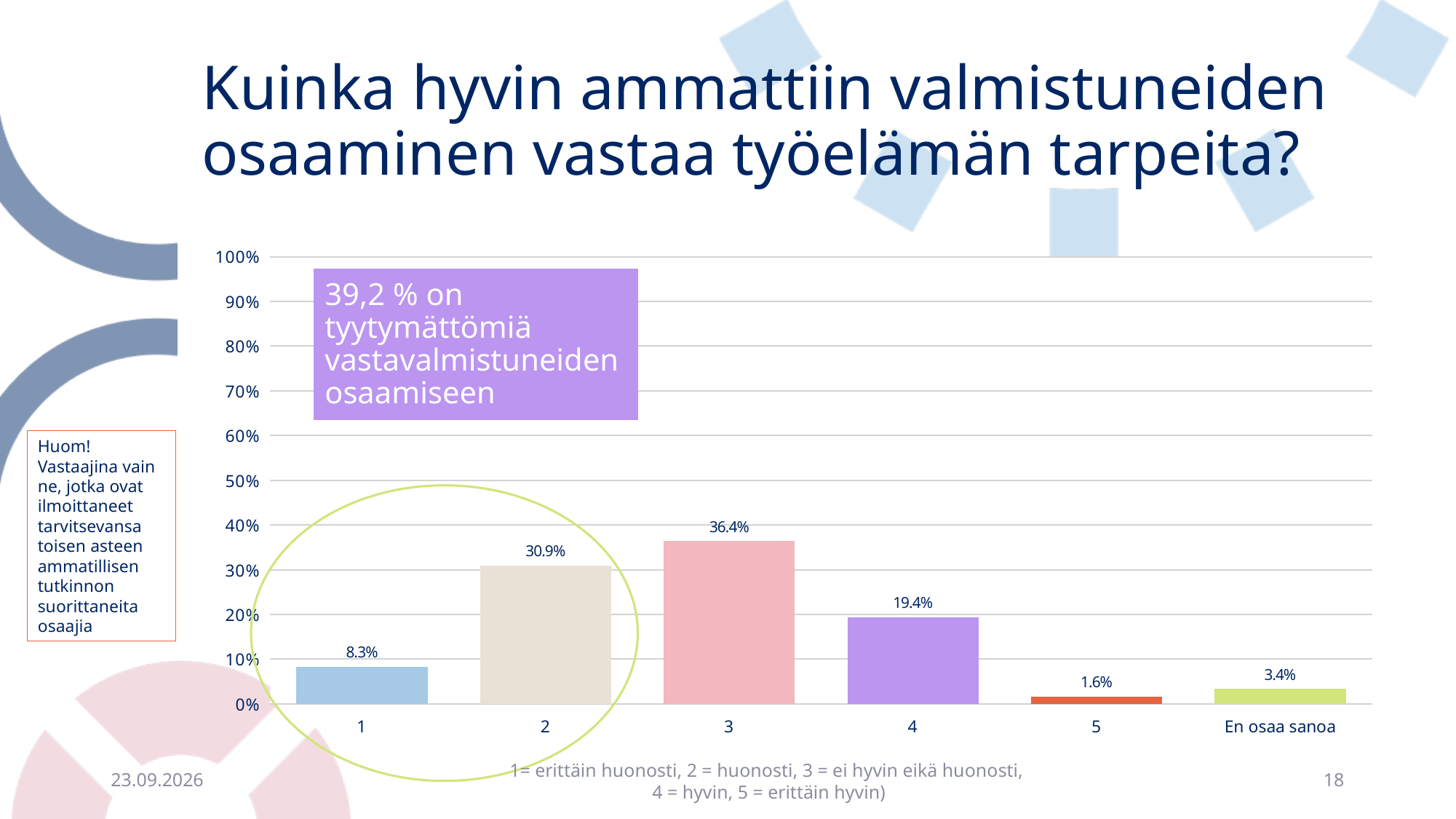
What is the value for "En osaa sanoa"? 3.4% What is the value for category 1? 8.3% What is the total of the values for categories 1 and 2? 39.2% How many categories are shown on the x axis? 6 What kind of chart is shown on the slide? bar chart What is the value for category 3? 36.4% What is the difference between the values for category 3 and category 4? 17.0% Which is larger, the value for category 2 or the value for category 4? 2 Which category has the highest value? 3 What is the difference between the values for category 2 and category 1? 22.6% Is the value for category 4 greater or less than 20%? less Which category has the lowest value? 5